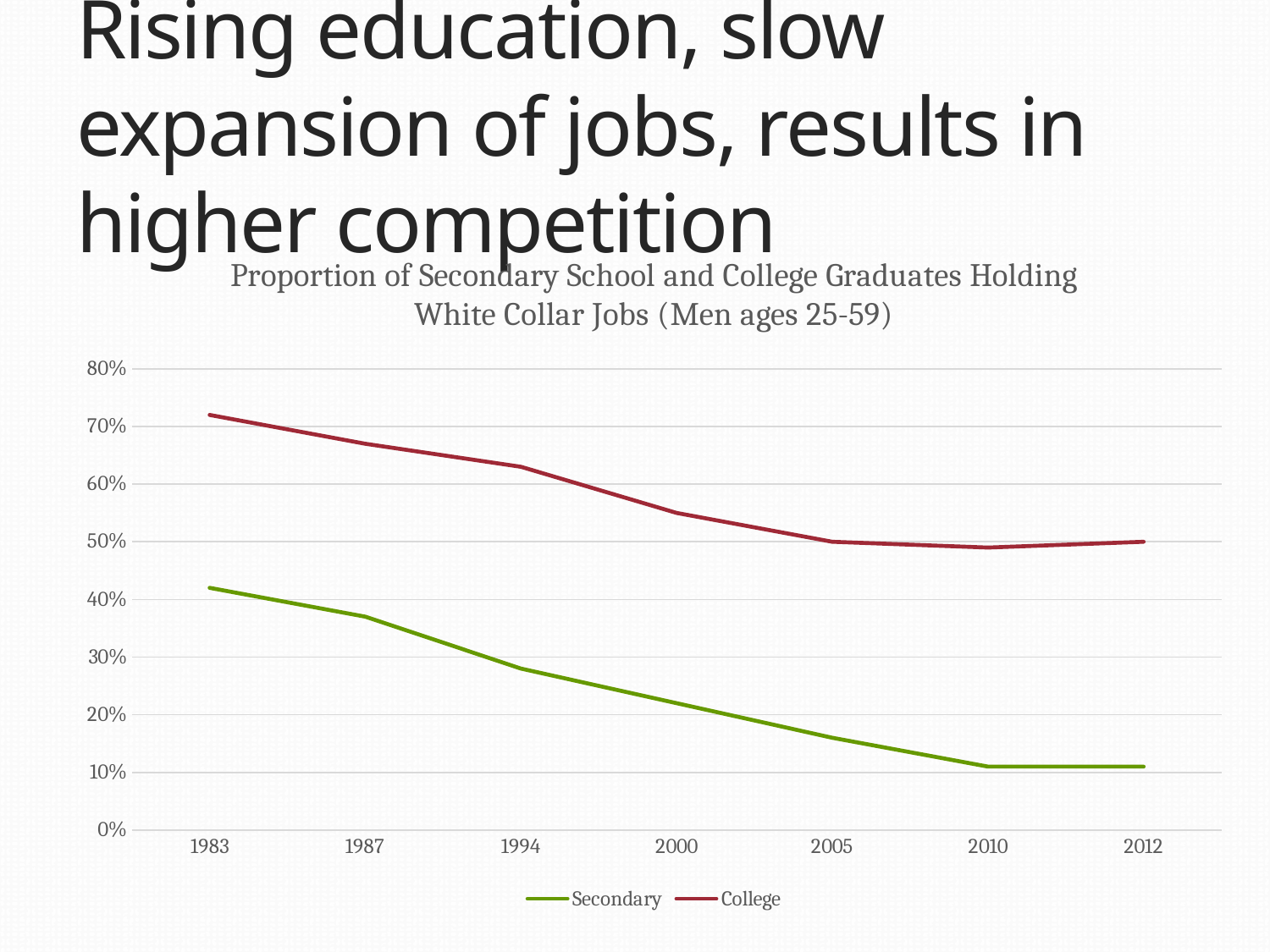
Does the Secondary series rise or fall from 1983 to 2012? fall Which series has the larger value in 2000, Secondary or College? College In which year is the Secondary series at its highest? 1983 How many series does the legend list? 2 Is the value for Secondary in 1994 greater or less than 40%? less Does the College series generally rise or fall from 1983 to 2005? fall Is the value for Secondary in 2010 greater or less than 20%? less Is the value for College in 1983 greater or less than 60%? greater In which year is the College series at its highest? 1983 How many years are shown on the x axis? 7 Which series is drawn in green? Secondary What kind of chart is shown on the slide? line chart